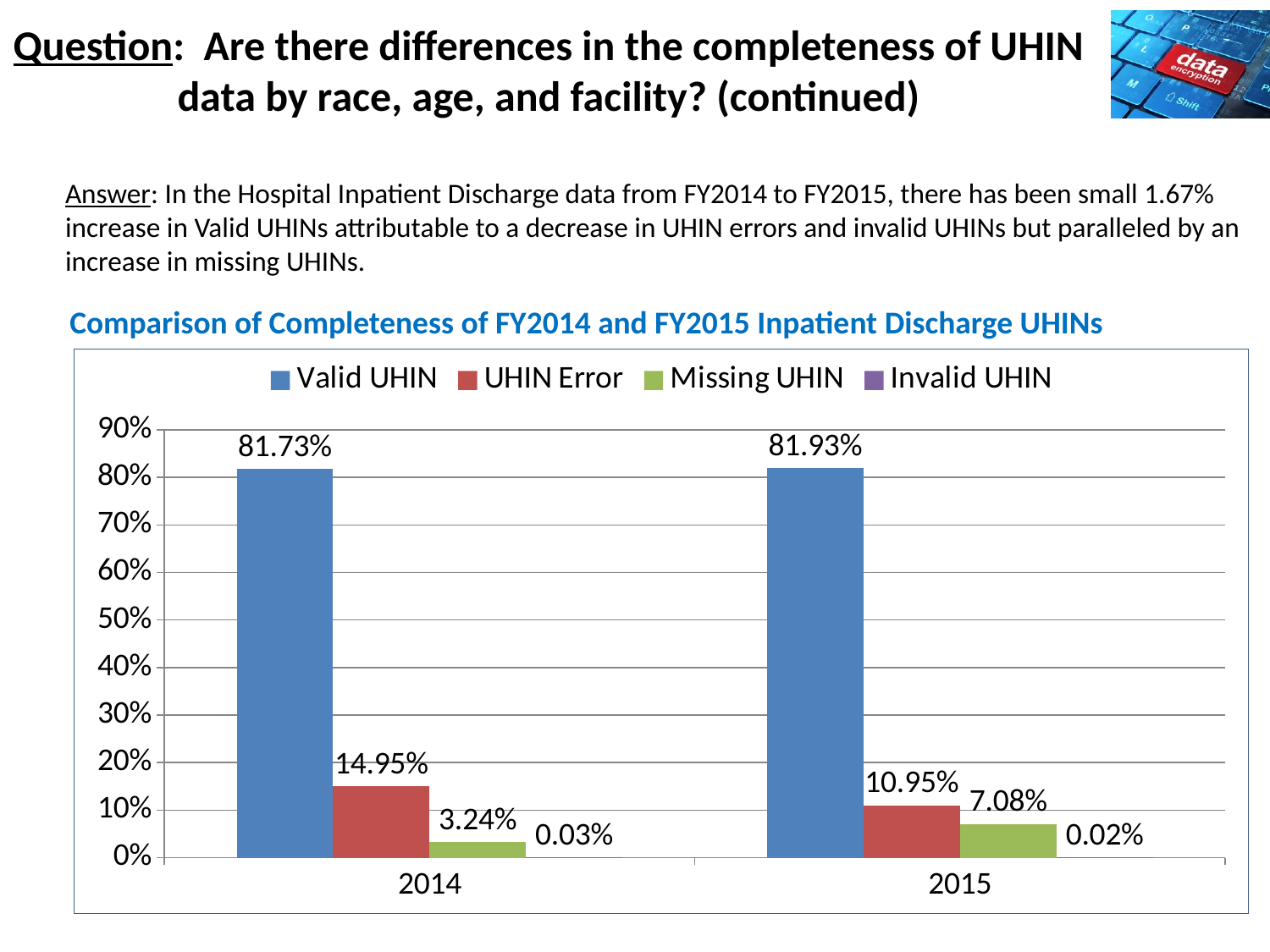
How many categories are shown on the x axis? 2 What is the value for Valid UHIN in 2014? 81.73% Which is larger, Missing UHIN in 2014 or Missing UHIN in 2015? Missing UHIN in 2015 Which series has the highest value in 2015? Valid UHIN Which series has the lowest value in 2014? Invalid UHIN What is the value for Invalid UHIN in 2015? 0.02% What kind of chart is shown? Bar chart What is the value for Missing UHIN in 2014? 3.24% How many series does the legend list? 4 What is the value for UHIN Error in 2015? 10.95% What is the difference between the UHIN Error values for 2014 and 2015? 4.00% What is the title of the chart? Comparison of Completeness of FY2014 and FY2015 Inpatient Discharge UHINs